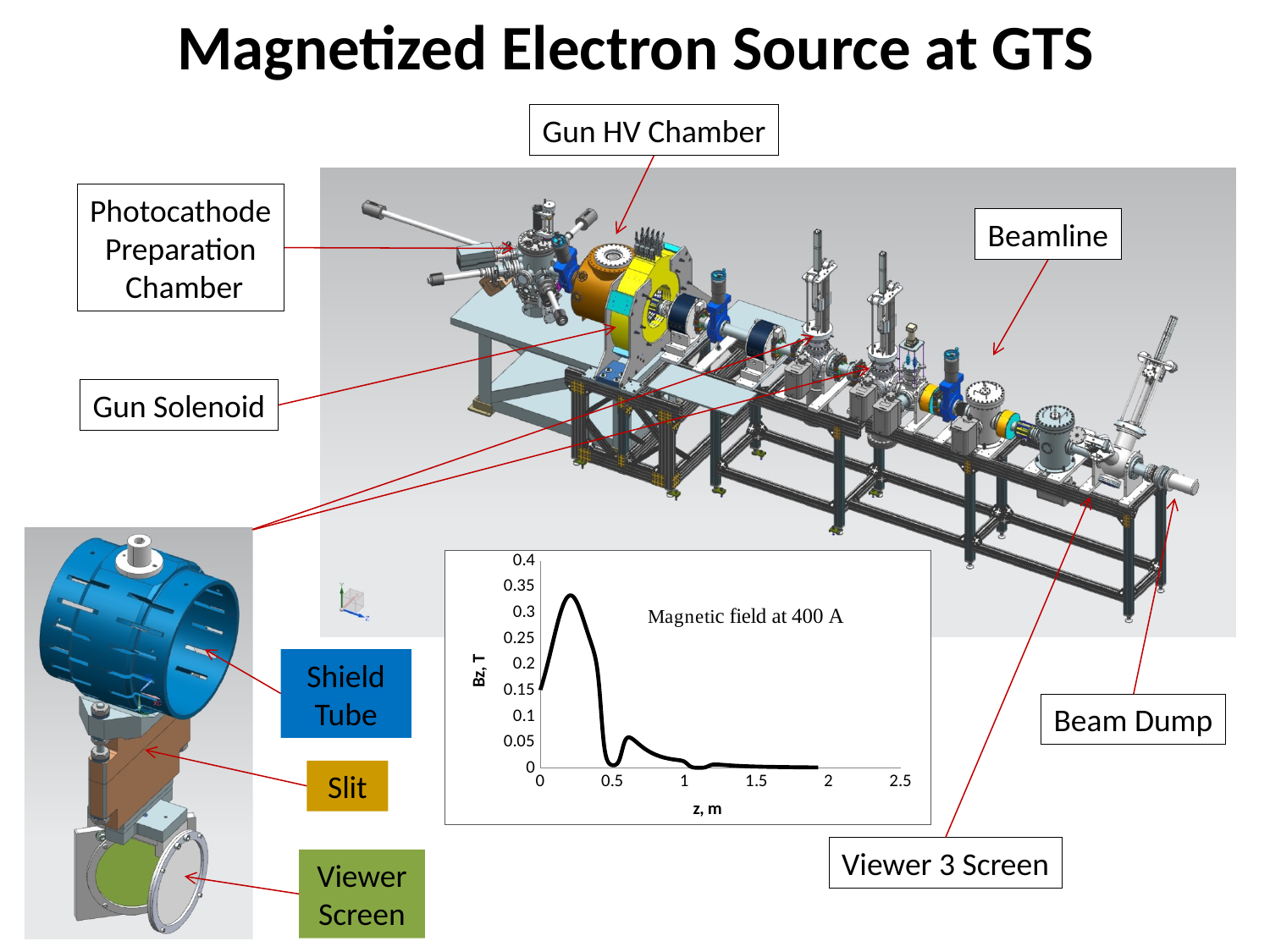
Is the peak value of Bz on the chart greater or less than 0.35? less What is the title printed inside the chart? Magnetic field at 400 A Is the value of Bz at z = 0.5 m greater or less than 0.1? less What kind of chart is shown on the slide? line chart What is the label of the vertical axis of the chart? Bz, T Is the value of Bz at z = 1 m greater or less than 0.05? less What is the highest tick value shown on the vertical axis of the chart? 0.4